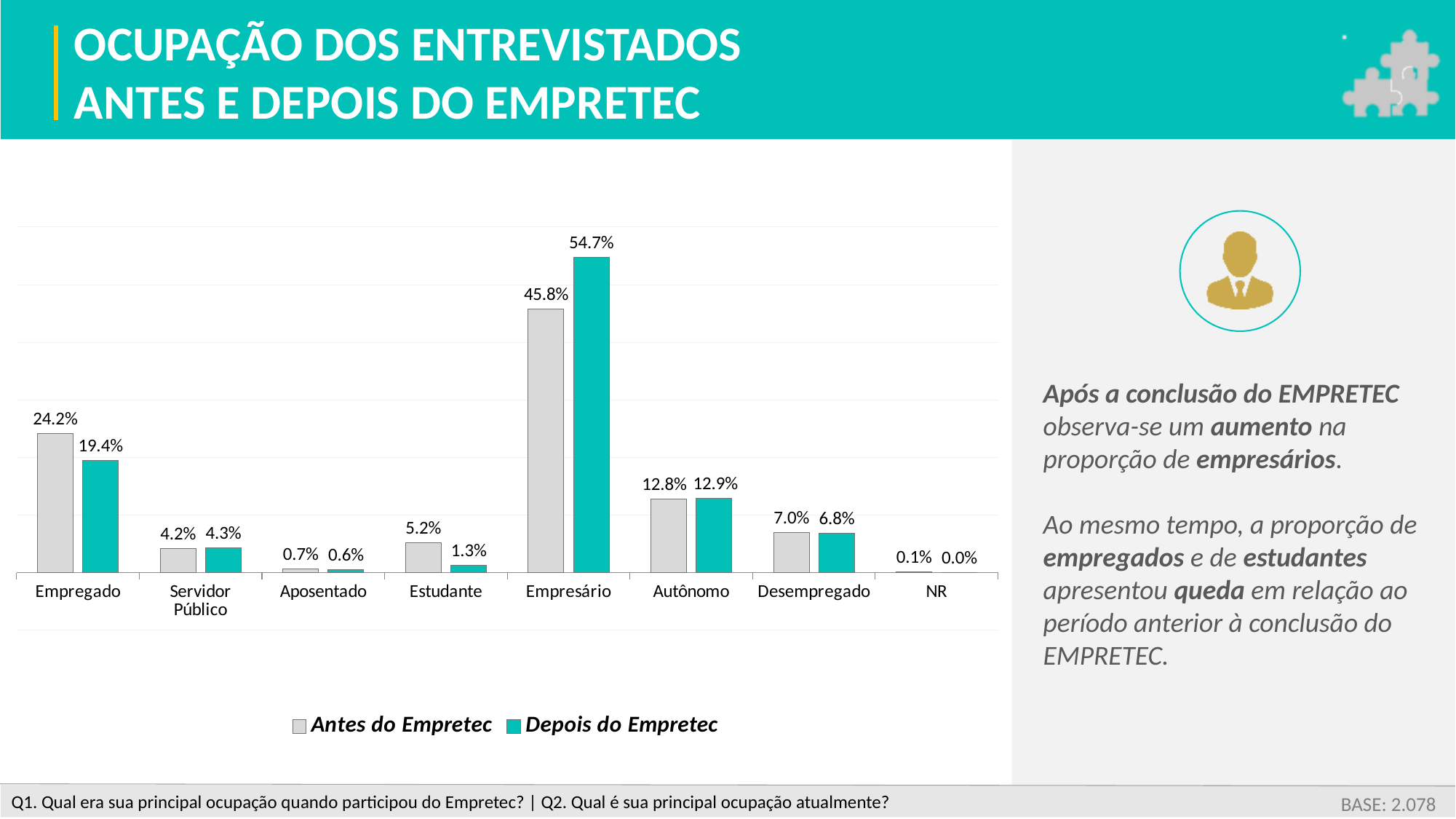
How many series does the legend list? 2 Which is larger for Estudante: the Antes do Empretec value or the Depois do Empretec value? Antes do Empretec What is the difference between the Depois do Empretec and Antes do Empretec values for Empresário? 8.9% What is the value for Empresário in the Depois do Empretec series? 54.7% How many occupation categories are shown on the x axis? 8 What is the difference between the Antes do Empretec and Depois do Empretec values for Empregado? 4.8% What colour are the bars for the Depois do Empretec series? Teal What kind of chart is shown on the slide? Bar chart What is the value for Empregado in the Antes do Empretec series? 24.2% Which category has the highest value in the Antes do Empretec series? Empresário Which category has the lowest value in the Depois do Empretec series? NR What is the value for Estudante in the Depois do Empretec series? 1.3%